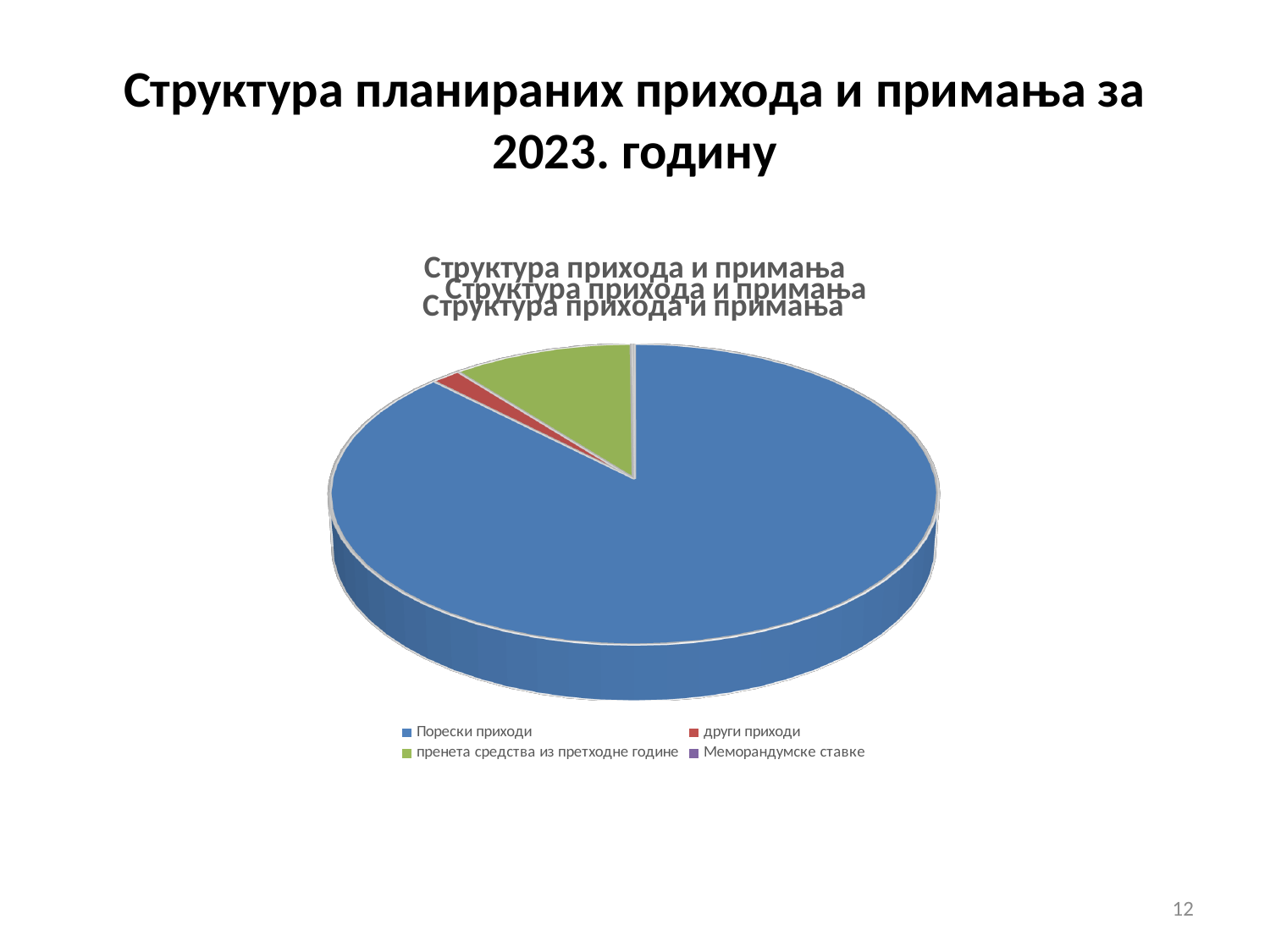
How many categories does the legend list? 4 What is the title of the chart? Структура прихода и примања Which slice is larger, Порески приходи or други приходи? Порески приходи Which category has the largest slice of the pie? Порески приходи What colour is the slice for Порески приходи? blue What kind of chart is shown on the slide? pie chart Which slice is larger, други приходи or пренета средства из претходне године? пренета средства из претходне године Which slice is larger, Порески приходи or пренета средства из претходне године? Порески приходи